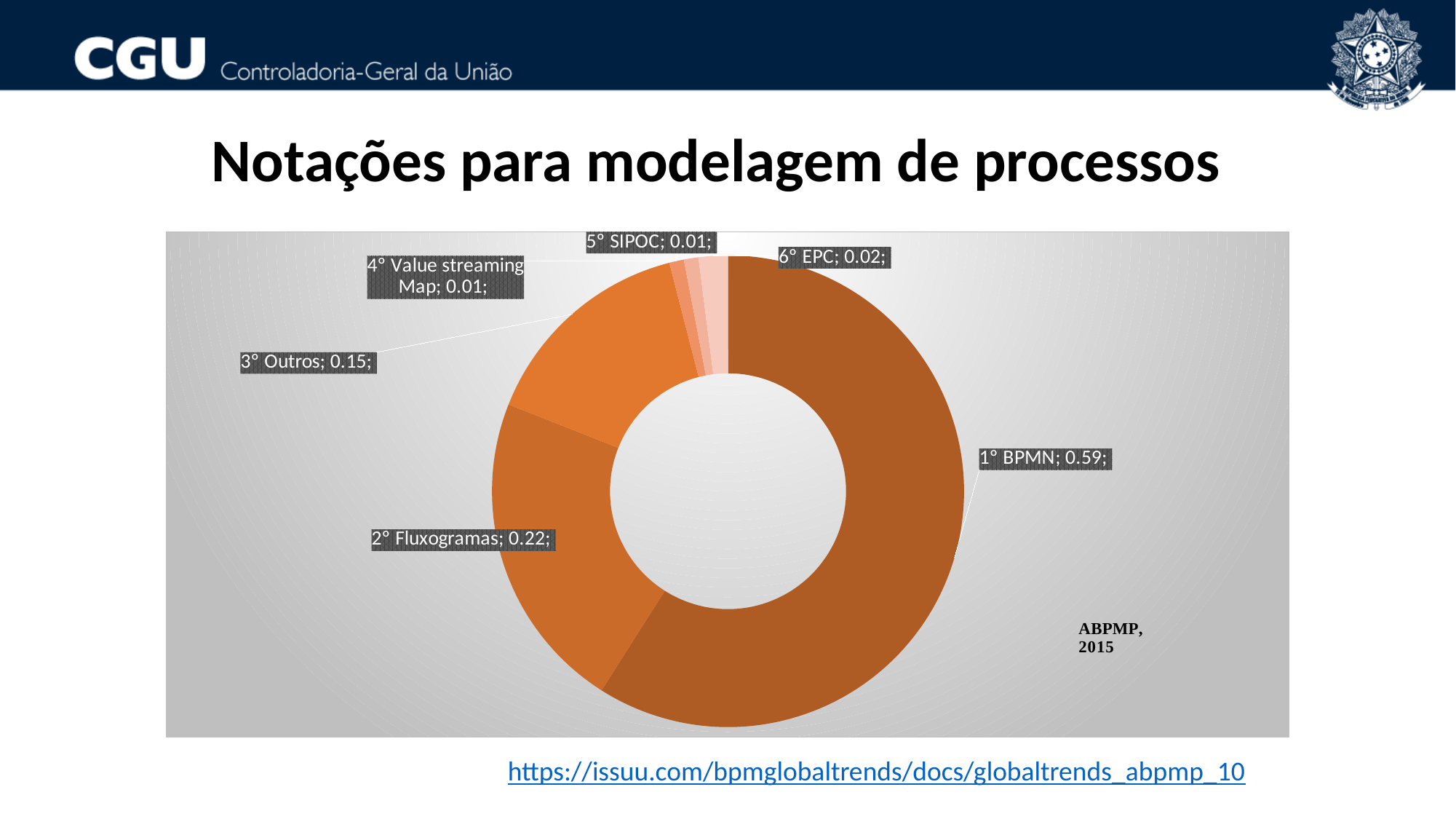
Which is larger, the value for 2° Fluxogramas or the value for 3° Outros? 2° Fluxogramas What source and year are cited next to the chart? ABPMP, 2015 What is the value shown for 1° BPMN? 0.59 Which category has the largest slice of the chart? 1° BPMN What is the value shown for 2° Fluxogramas? 0.22 What is the difference between the values for 1° BPMN and 2° Fluxogramas? 0.37 What is the title of the slide containing the chart? Notações para modelagem de processos What is the value shown for 6° EPC? 0.02 How many categories (slices) does the chart show? 6 What kind of chart is shown on the slide? Doughnut (pie) chart What is the value shown for 5° SIPOC? 0.01 What is the value shown for 3° Outros? 0.15